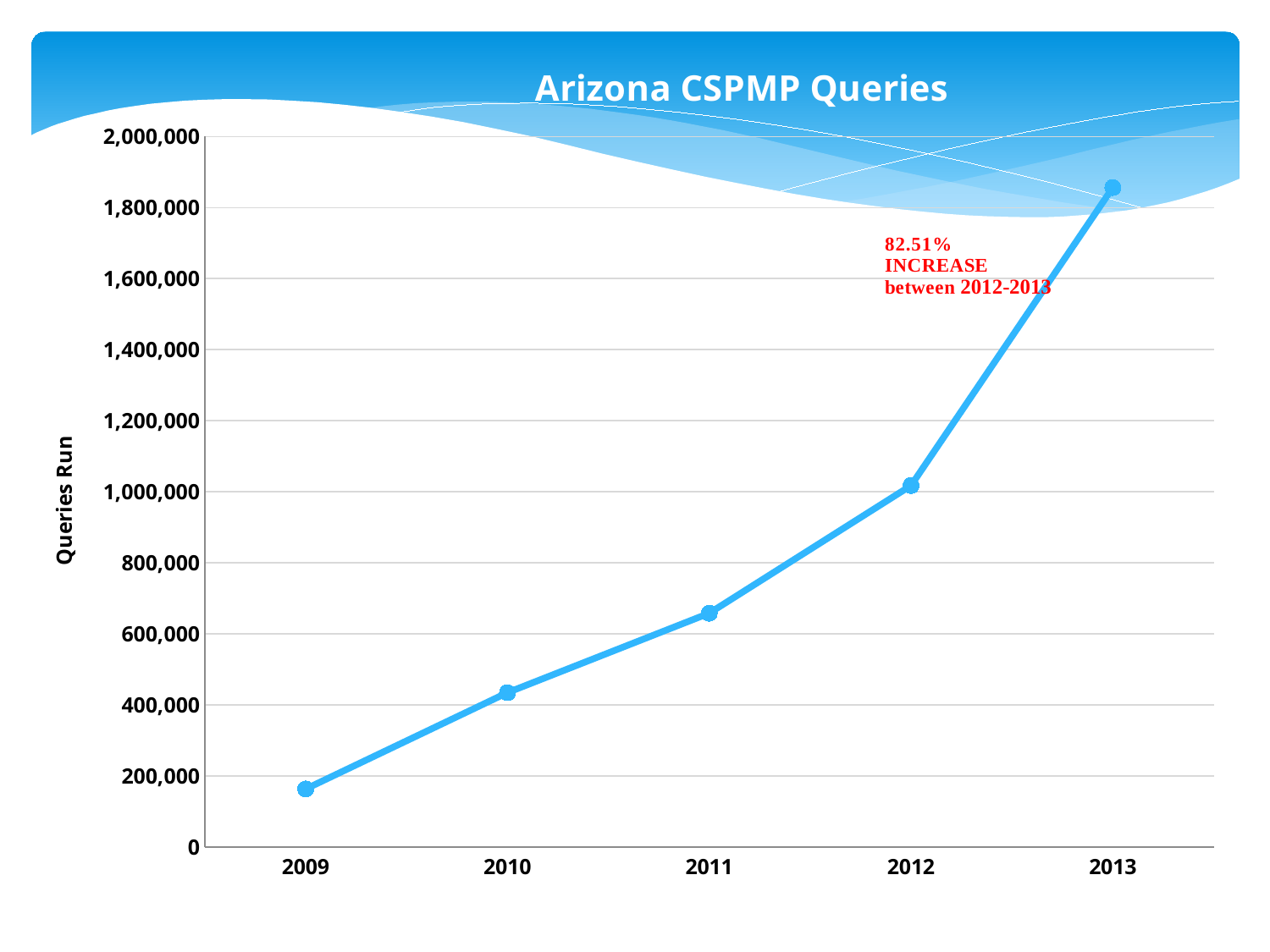
Is the value for 2011 greater or less than 600,000? greater Which year has more queries run, 2011 or 2012? 2012 Which year has the lowest number of queries run? 2009 How many years are plotted on the x axis? 5 What is the label on the vertical axis? Queries Run Which year has the highest number of queries run? 2013 Is the value for 2010 greater or less than 400,000? greater Is the value for 2009 greater or less than 200,000? less Do the values rise or fall from 2009 to 2013? rise What kind of chart is shown on the slide? line chart What is the title of the chart? Arizona CSPMP Queries